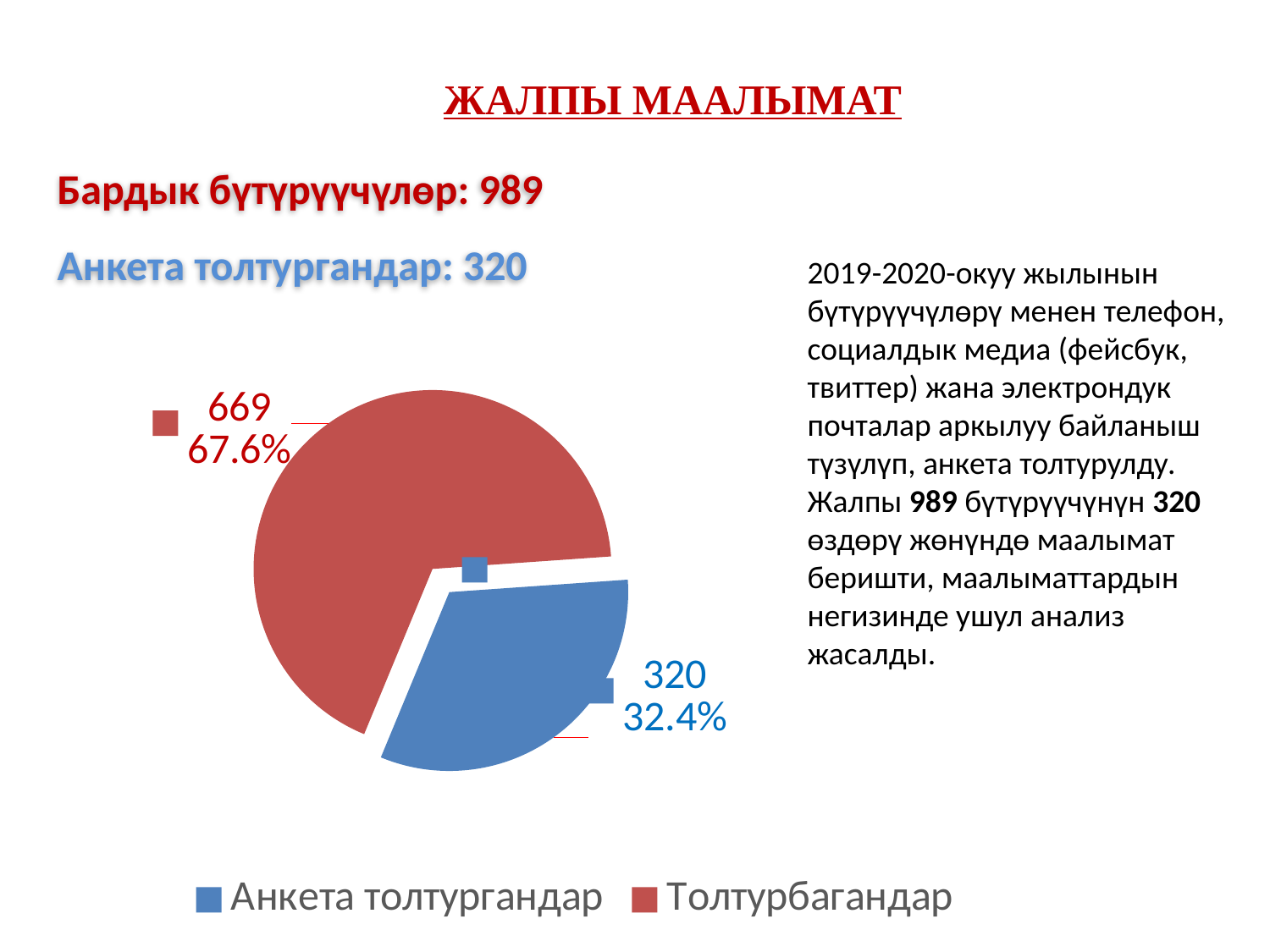
How many slices does the pie chart have? 2 What kind of chart is shown on the slide? pie chart What percentage share of the pie does "Толтурбагандар" have? 67.6% What is the value shown for the "Толтурбагандар" slice? 669 How many entries does the legend of the pie chart list? 2 What is the value shown for the "Анкета толтургандар" slice? 320 What is the difference between the values of "Толтурбагандар" and "Анкета толтургандар"? 349 What is the total of the two slice values in the pie chart? 989 Which slice of the pie chart is the largest? Толтурбагандар What percentage share of the pie does "Анкета толтургандар" have? 32.4% Which slice of the pie chart is the smallest? Анкета толтургандар Which colour represents "Анкета толтургандар" in the pie chart? blue